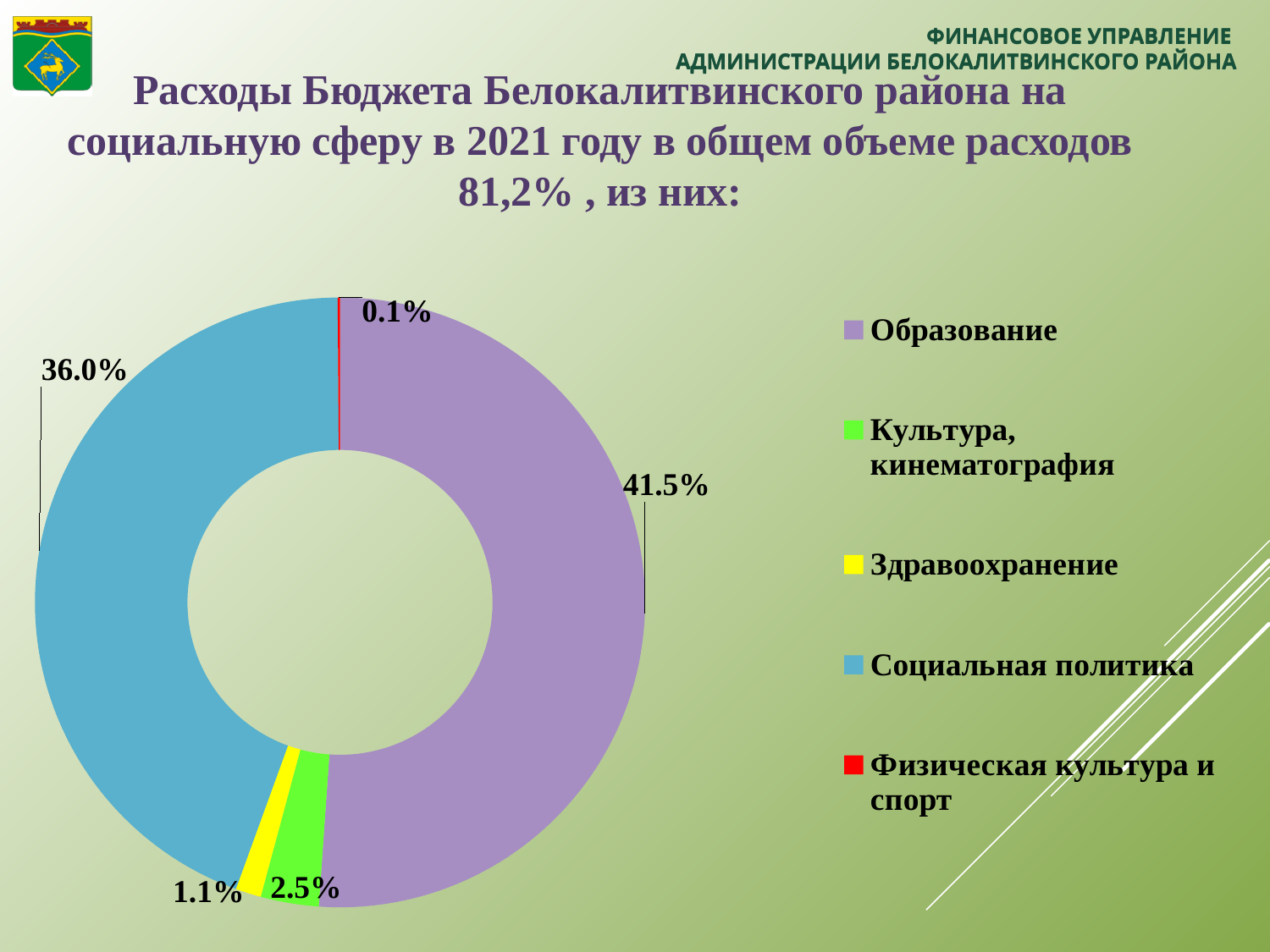
What is the difference between the shares of Образование and Социальная политика? 5.5% What is the value for Здравоохранение? 1.1% What kind of chart is shown on the slide? Doughnut (pie) chart What percentage is shown for Культура, кинематография? 2.5% Which is larger, the share for Культура, кинематография or the share for Здравоохранение? Культура, кинематография How many categories are shown in the chart? 5 Which category has the largest share of the chart? Образование What share is shown for Физическая культура и спорт? 0.1% What colour represents Социальная политика in the chart? Blue Which category has the smallest share of the chart? Физическая культура и спорт What share of the chart does Образование account for? 41.5% What is the value shown for Социальная политика? 36.0%